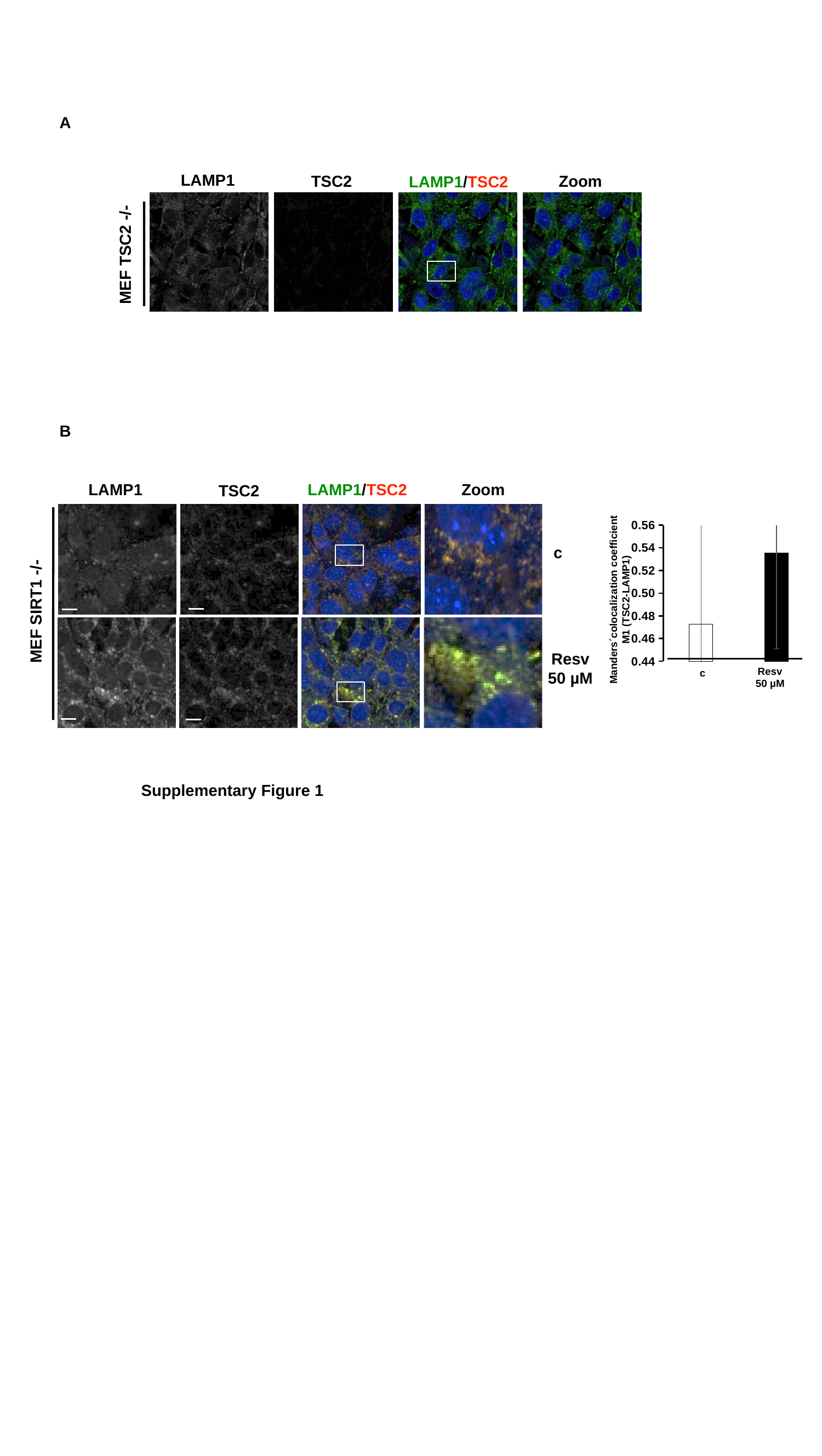
What kind of chart is shown on the right of panel B? bar chart In the bar chart, which category has the lowest Manders' colocalization coefficient? c In the bar chart, is the value for c greater or less than 0.46? greater In the bar chart, which is larger, the value for c or the value for Resv 50 µM? Resv 50 µM What is the y-axis label of the bar chart? Manders' colocalization coefficient M1 (TSC2-LAMP1) In the bar chart, which category has the highest Manders' colocalization coefficient? Resv 50 µM In the bar chart, what colour is the bar for Resv 50 µM? black In the bar chart, is the value for c greater or less than 0.50? less In the bar chart, is the value for Resv 50 µM greater or less than 0.56? less In the bar chart, what is the lowest value shown on the y axis? 0.44 In the bar chart, how many categories are shown on the x axis? 2